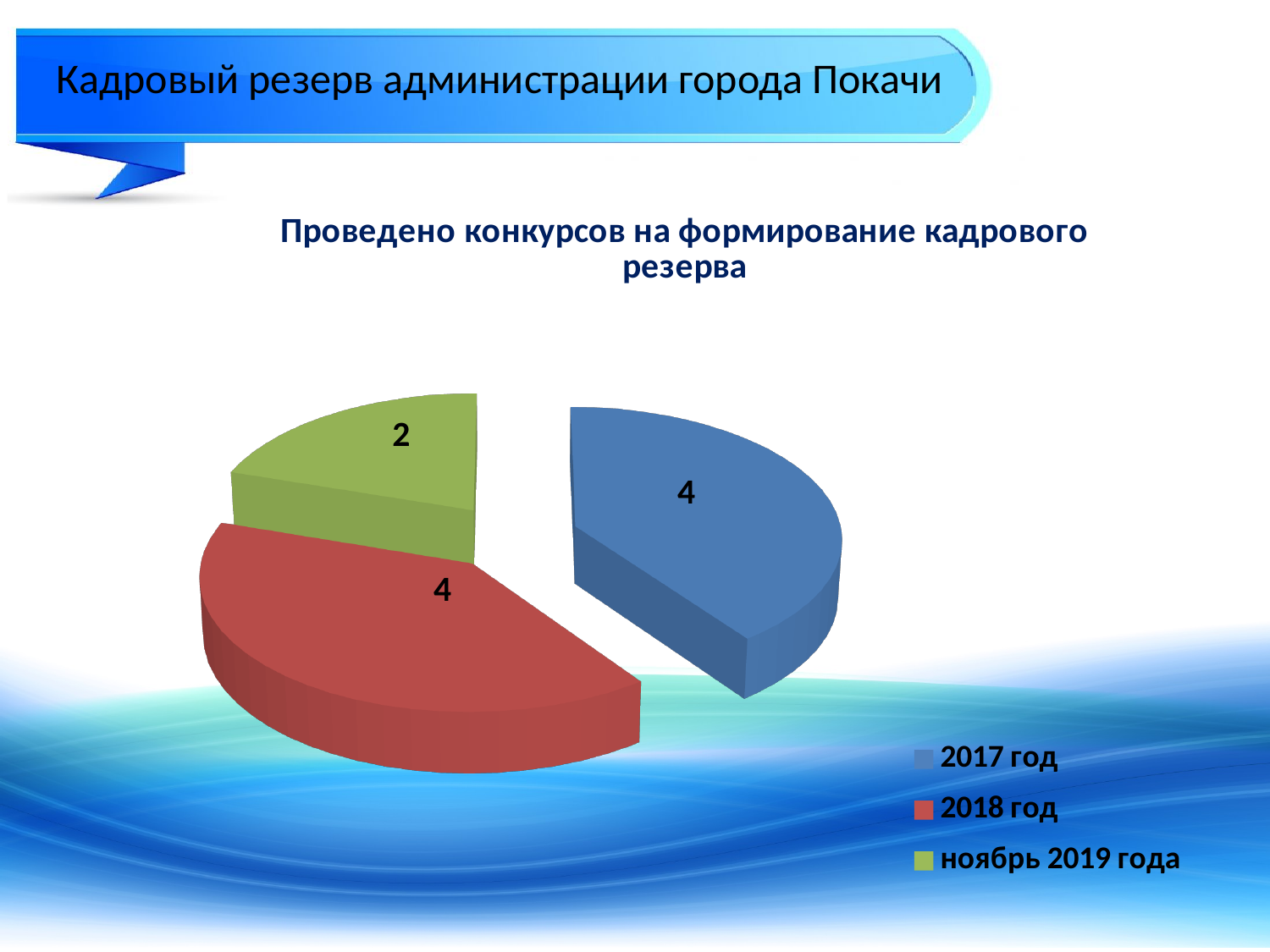
Which is larger, the value for 2017 год or the value for ноябрь 2019 года? 2017 год What share of the pie does ноябрь 2019 года represent? 20% What is the value for ноябрь 2019 года? 2 Which category has the smallest slice? ноябрь 2019 года What share of the pie does 2018 год represent? 40% What kind of chart is shown on the slide? pie chart What is the title of the chart? Проведено конкурсов на формирование кадрового резерва What is the difference between the value for 2018 год and the value for ноябрь 2019 года? 2 What is the value for 2018 год? 4 How many slices does the pie chart have? 3 What is the value for 2017 год? 4 How many entries does the legend list? 3